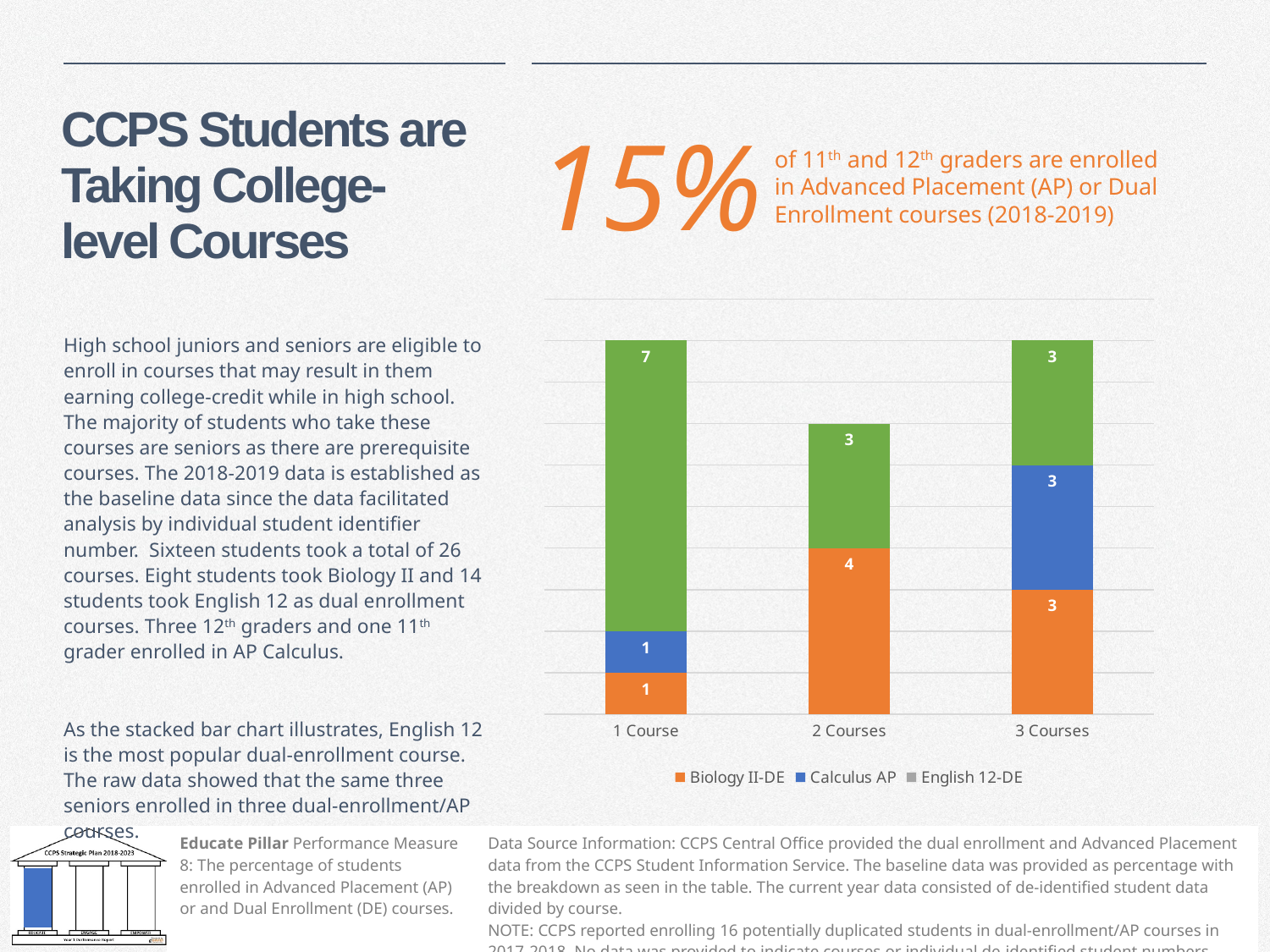
Which category has the larger Biology II-DE value, 1 Course or 2 Courses? 2 Courses What is the total of the stacked bar for 2 Courses? 7 What is the English 12-DE value for the 1 Course category? 7 What is the difference between the English 12-DE value for 1 Course and for 3 Courses? 4 How many categories are shown on the x axis of the chart? 3 Which category has the highest English 12-DE value? 1 Course What is the total of the stacked bar for 1 Course? 9 What is the Biology II-DE value for the 2 Courses category? 4 How many series does the chart legend list? 3 Which category has the lowest stacked bar total? 2 Courses What is the Calculus AP value for the 3 Courses category? 3 What kind of chart is shown on the slide? Stacked bar chart